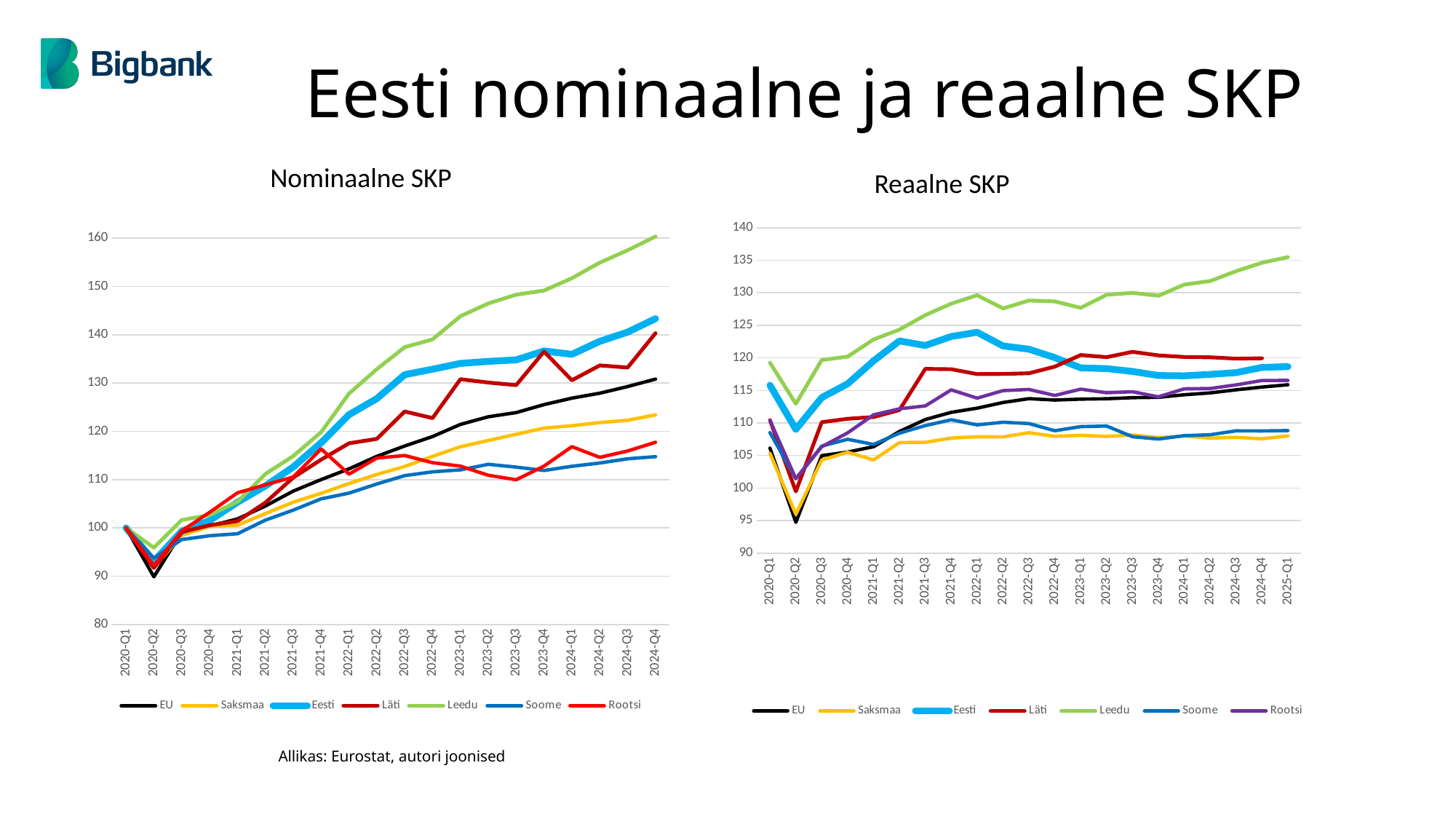
How many quarters are plotted on the x axis of the Reaalne SKP chart? 21 In the Nominaalne SKP chart, is the value for Leedu at 2024-Q4 greater or less than 150? greater In the Reaalne SKP chart, which series is highest at 2025-Q1? Leedu In the Reaalne SKP chart, is the value for EU at 2020-Q2 greater or less than 100? less How many quarters are plotted on the x axis of the Nominaalne SKP chart? 20 In the Nominaalne SKP chart, at which quarter does the EU series reach its lowest value? 2020-Q2 What type of chart is the Nominaalne SKP chart? line chart In the Nominaalne SKP chart, is the value for Soome at 2024-Q4 greater or less than 120? less In the Reaalne SKP chart, which is larger at 2025-Q1, Leedu or Eesti? Leedu How many series does the legend of the Reaalne SKP chart list? 7 In the Nominaalne SKP chart, does the EU series rise or fall overall from 2020-Q1 to 2024-Q4? rise In the Nominaalne SKP chart, which series is highest at 2024-Q4? Leedu